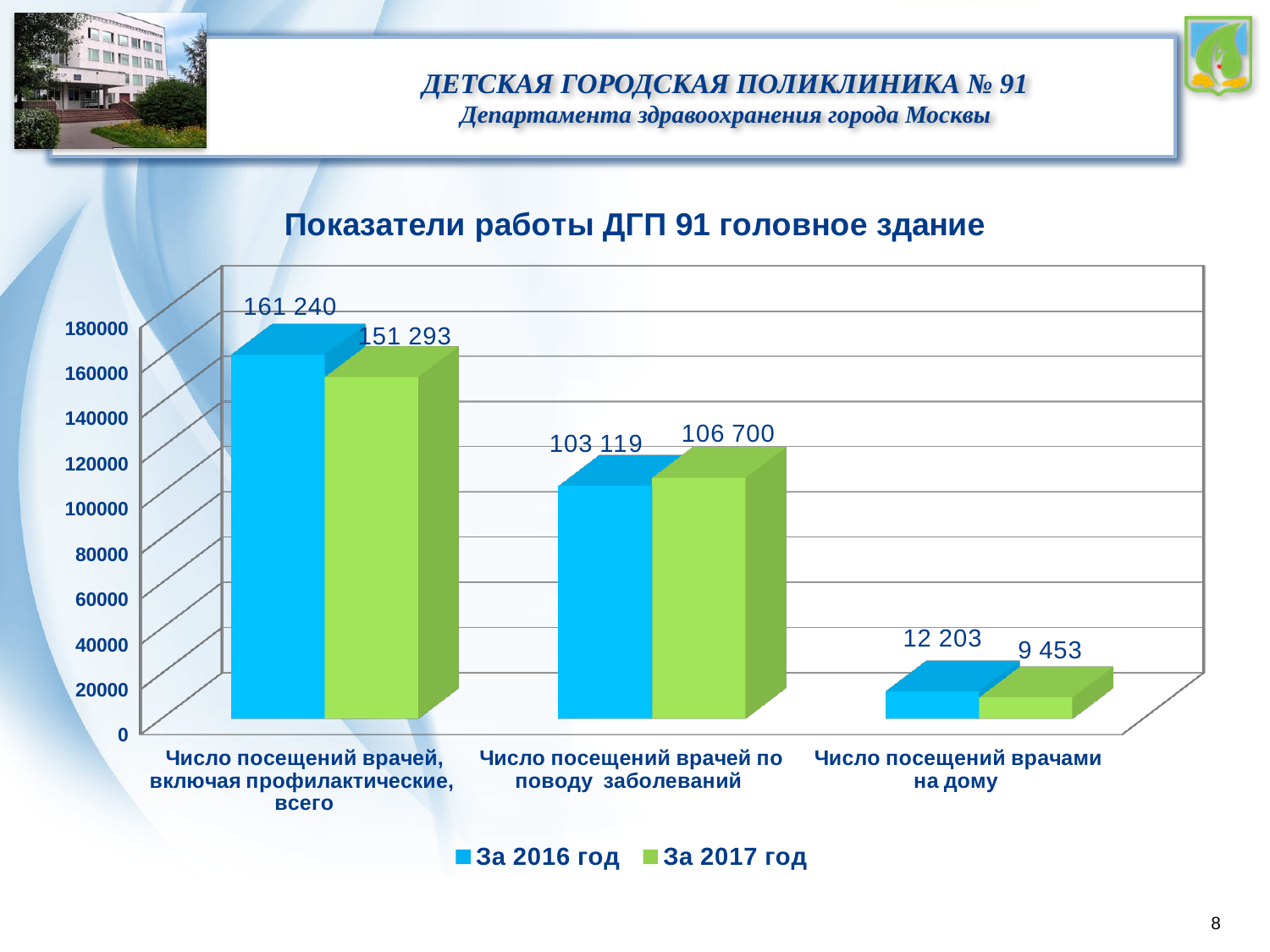
Which category has the lowest value in the "За 2017 год" series? Число посещений врачами на дому What kind of chart is shown on the slide? Bar chart Which category has the highest value in the "За 2016 год" series? Число посещений врачей, включая профилактические, всего What is the title of the chart? Показатели работы ДГП 91 головное здание How many categories are shown on the x axis? 3 For "Число посещений врачей по поводу заболеваний", which series has the larger value, "За 2016 год" or "За 2017 год"? За 2017 год What is the difference between the 2016 and 2017 values for "Число посещений врачей, включая профилактические, всего"? 9 947 How many series does the legend list? 2 What is the value for "Число посещений врачей по поводу заболеваний" in the "За 2017 год" series? 106 700 What is the value for "Число посещений врачей, включая профилактические, всего" in the "За 2016 год" series? 161 240 What is the value for "Число посещений врачами на дому" in the "За 2016 год" series? 12 203 What is the difference between the 2016 and 2017 values for "Число посещений врачами на дому"? 2 750